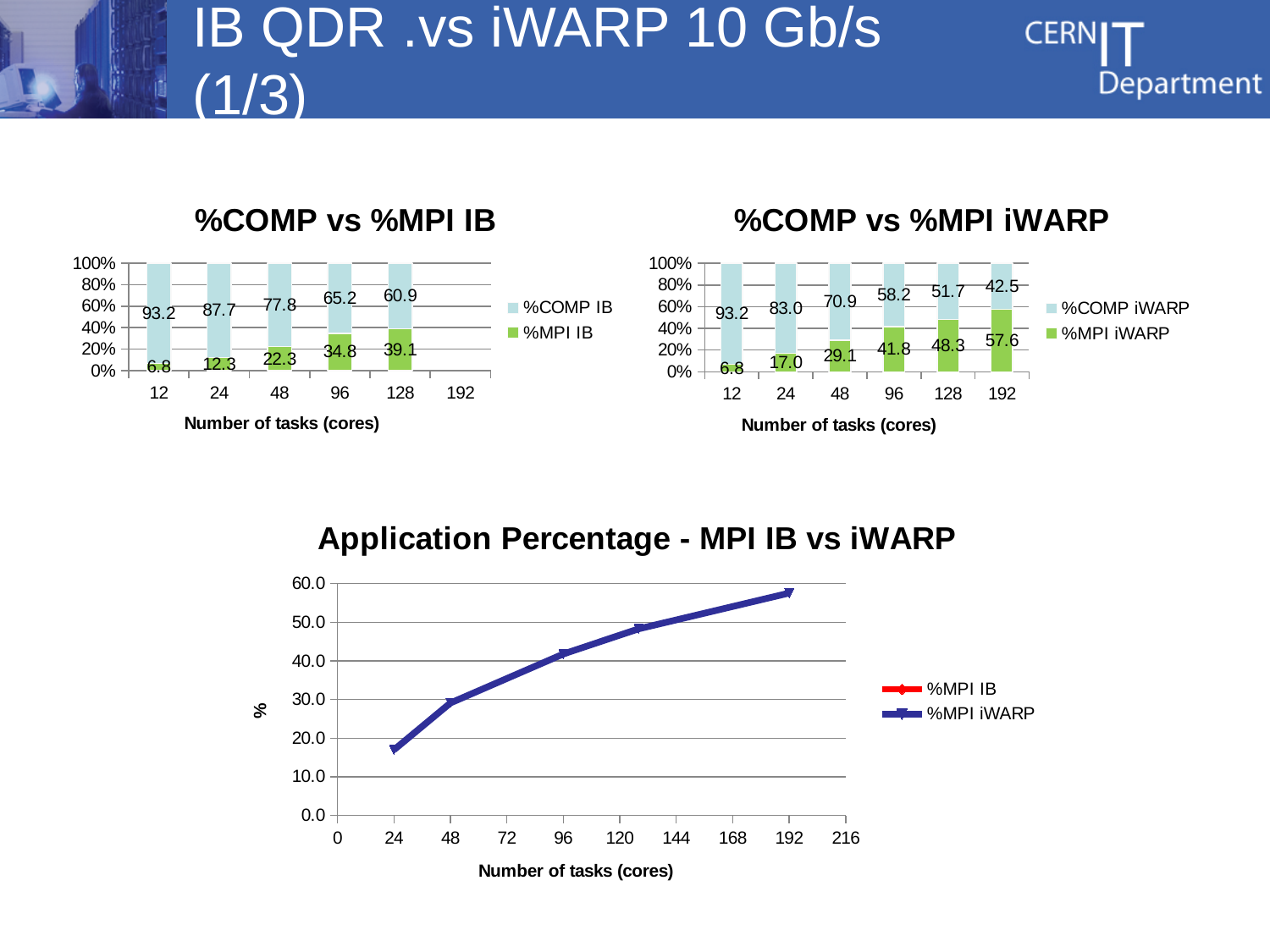
How many stacked bars are plotted in the "%COMP vs %MPI iWARP" chart? 6 In the "Application Percentage - MPI IB vs iWARP" chart, is the value at 24 tasks greater or less than 20.0? less In the "%COMP vs %MPI iWARP" chart, what is the difference between %MPI iWARP at 192 tasks and at 12 tasks? 50.8 In the "%COMP vs %MPI IB" chart, what is the %COMP IB value at 128 tasks? 60.9 In the "%COMP vs %MPI IB" chart, what is the %MPI IB value at 48 tasks? 22.3 In the "%COMP vs %MPI iWARP" chart, what is the %COMP iWARP value at 96 tasks? 58.2 In the "%COMP vs %MPI iWARP" chart, at which number of tasks is %MPI iWARP highest? 192 What kind of chart is "Application Percentage - MPI IB vs iWARP"? line chart At 96 tasks, which is larger: %MPI IB in the left chart or %MPI iWARP in the right chart? %MPI iWARP How many series does the legend of the "Application Percentage - MPI IB vs iWARP" chart list? 2 In the "%COMP vs %MPI IB" chart, at which number of tasks is %COMP IB lowest? 128